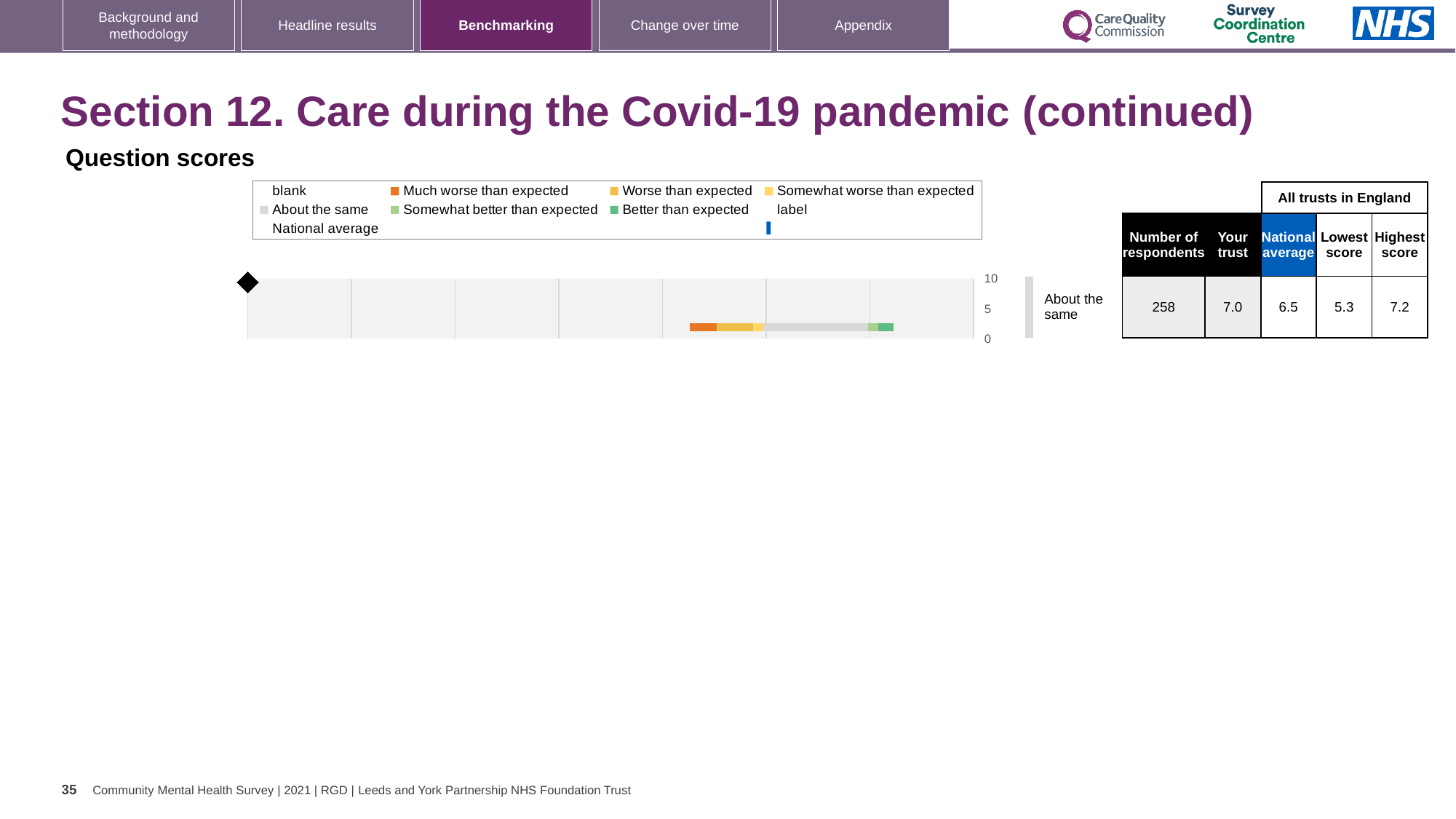
How many respondents are shown for this question? 258 What is the lowest score among all trusts in England for this question? 5.3 What benchmark category label is shown next to the chart for this question? About the same What is the difference between the 'Your trust' score and the national average for this question? 0.5 What kind of chart is used to show the question score on this slide? Bar chart What is the maximum value shown on the chart's axis? 10 Which is larger for this question, the 'Your trust' score or the national average? Your trust What is the 'Your trust' score shown for the question on this slide? 7.0 What is the highest score among all trusts in England for this question? 7.2 What is the difference between the highest and lowest scores among all trusts in England for this question? 1.9 What is the national average score shown for this question? 6.5 What colour does the legend use for 'Much worse than expected'? Orange